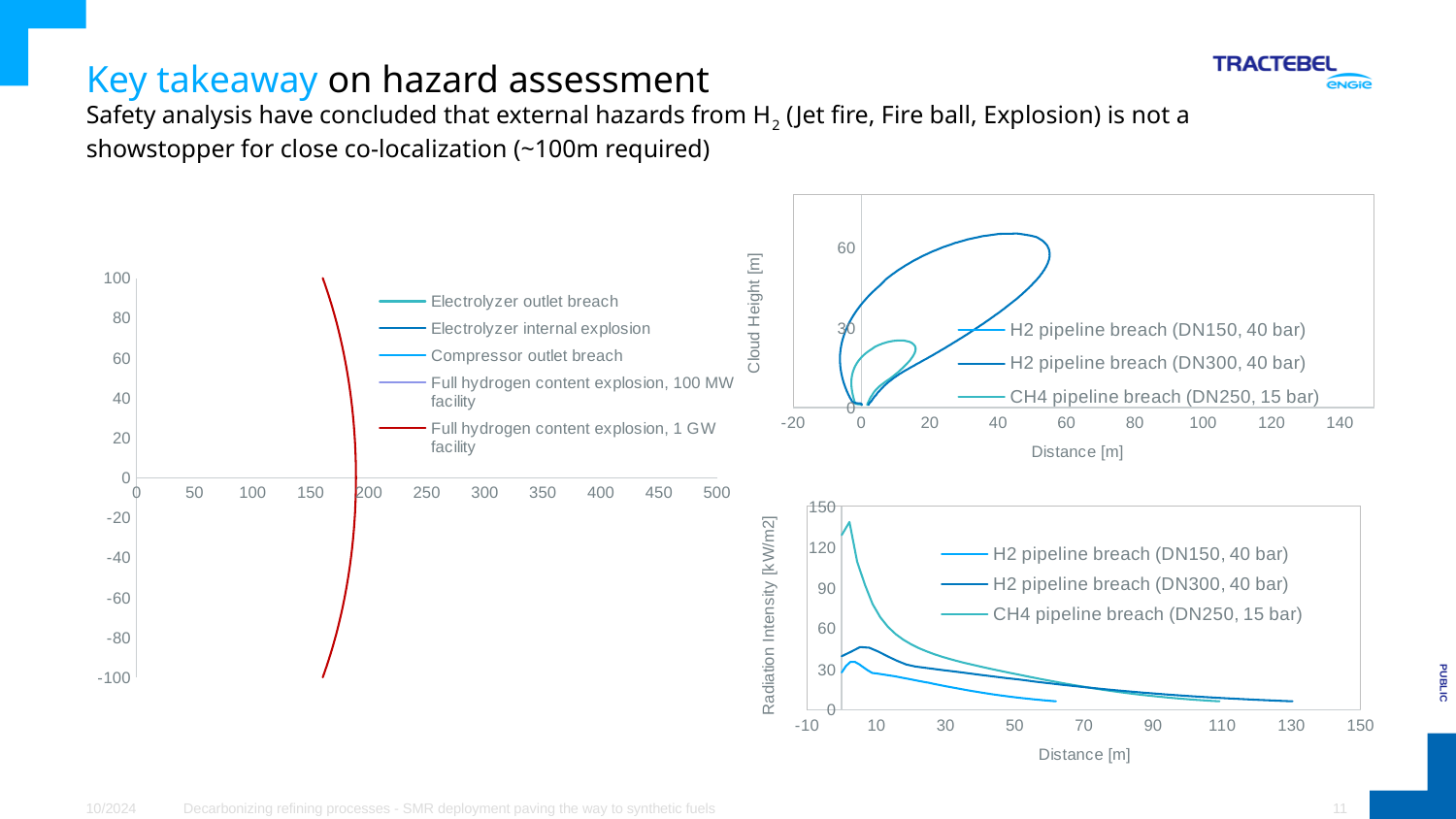
In the top-right chart (Cloud Height), is the maximum cloud height of the H2 pipeline breach (DN300, 40 bar) series greater or less than 60? greater What kind of chart is the bottom-right chart (Radiation Intensity)? line chart In the bottom-right chart (Radiation Intensity), which series reaches the highest radiation intensity? CH4 pipeline breach (DN250, 15 bar) How many series does the legend of the left chart list? 5 How many series does the legend of the top-right chart (Cloud Height) list? 3 In the bottom-right chart (Radiation Intensity), does the radiation intensity rise or fall as distance increases beyond about 10 m? fall In the bottom-right chart, what is the label of the y axis? Radiation Intensity [kW/m2] In the bottom-right chart (Radiation Intensity), is the peak value of the CH4 pipeline breach (DN250, 15 bar) series greater or less than 120? greater In the top-right chart, what is the label of the y axis? Cloud Height [m] In the top-right chart (Cloud Height), which series reaches the greatest cloud height? H2 pipeline breach (DN300, 40 bar) How many series does the legend of the bottom-right chart (Radiation Intensity) list? 3 In the bottom-right chart (Radiation Intensity), is the peak value of the H2 pipeline breach (DN150, 40 bar) series greater or less than 60? less